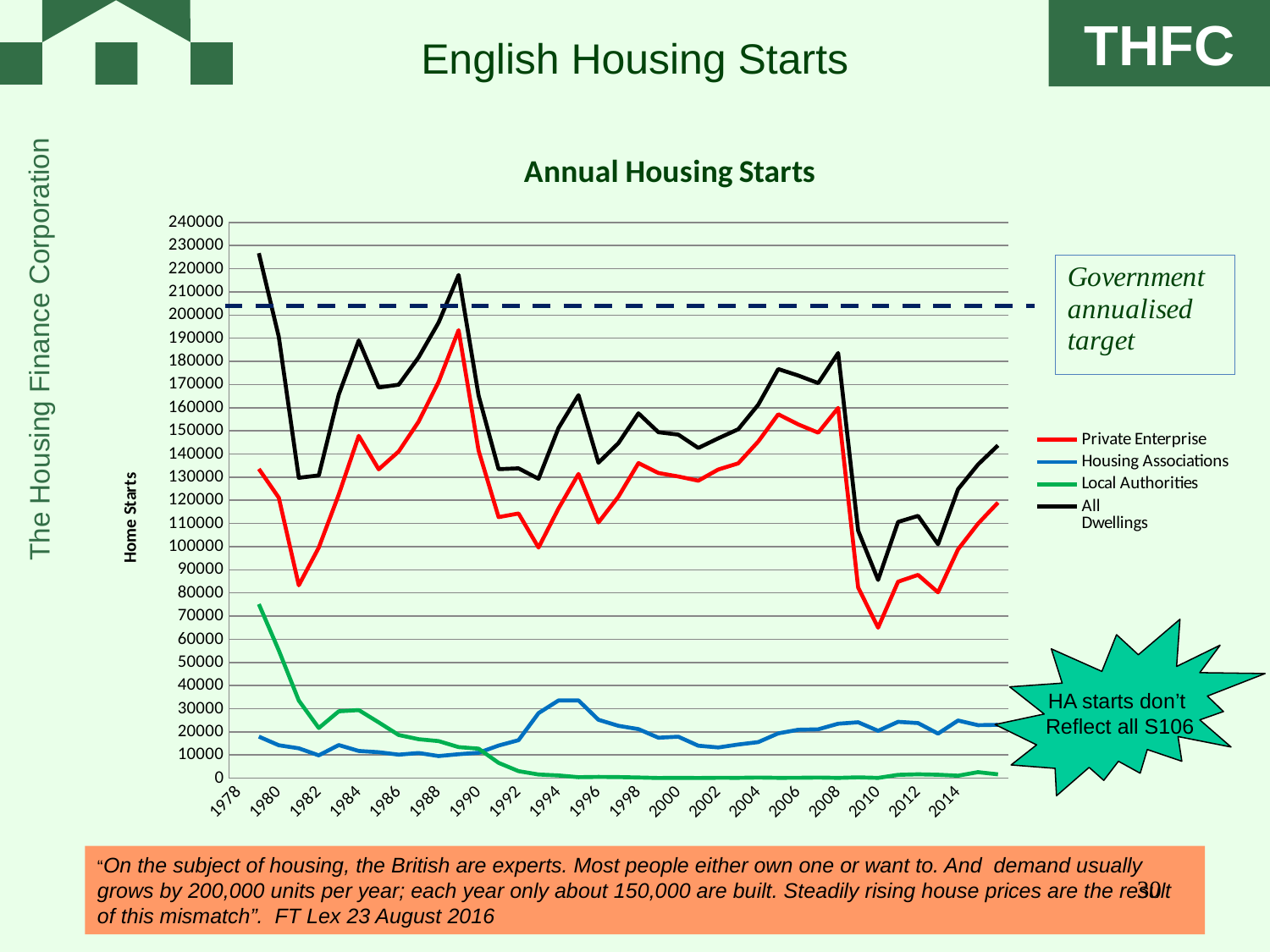
In which year does the Private Enterprise series reach its lowest value? 2010 What does the horizontal dashed line on the chart represent? Government annualised target In which year does the All Dwellings series reach its lowest value? 2010 What kind of chart is shown on the slide? Line chart Which series has the highest values across the chart? All Dwellings What is the title of the chart? Annual Housing Starts Which is larger in 2000, Private Enterprise or Housing Associations? Private Enterprise Is the value for Private Enterprise in 2010 greater or less than 80000? less How many series does the chart legend list? 4 Is the value for Local Authorities in 2000 greater or less than 10000? less Do the Local Authorities values rise or fall from 1979 to 1992? fall Is the value for All Dwellings in 1979 greater or less than 200000? greater